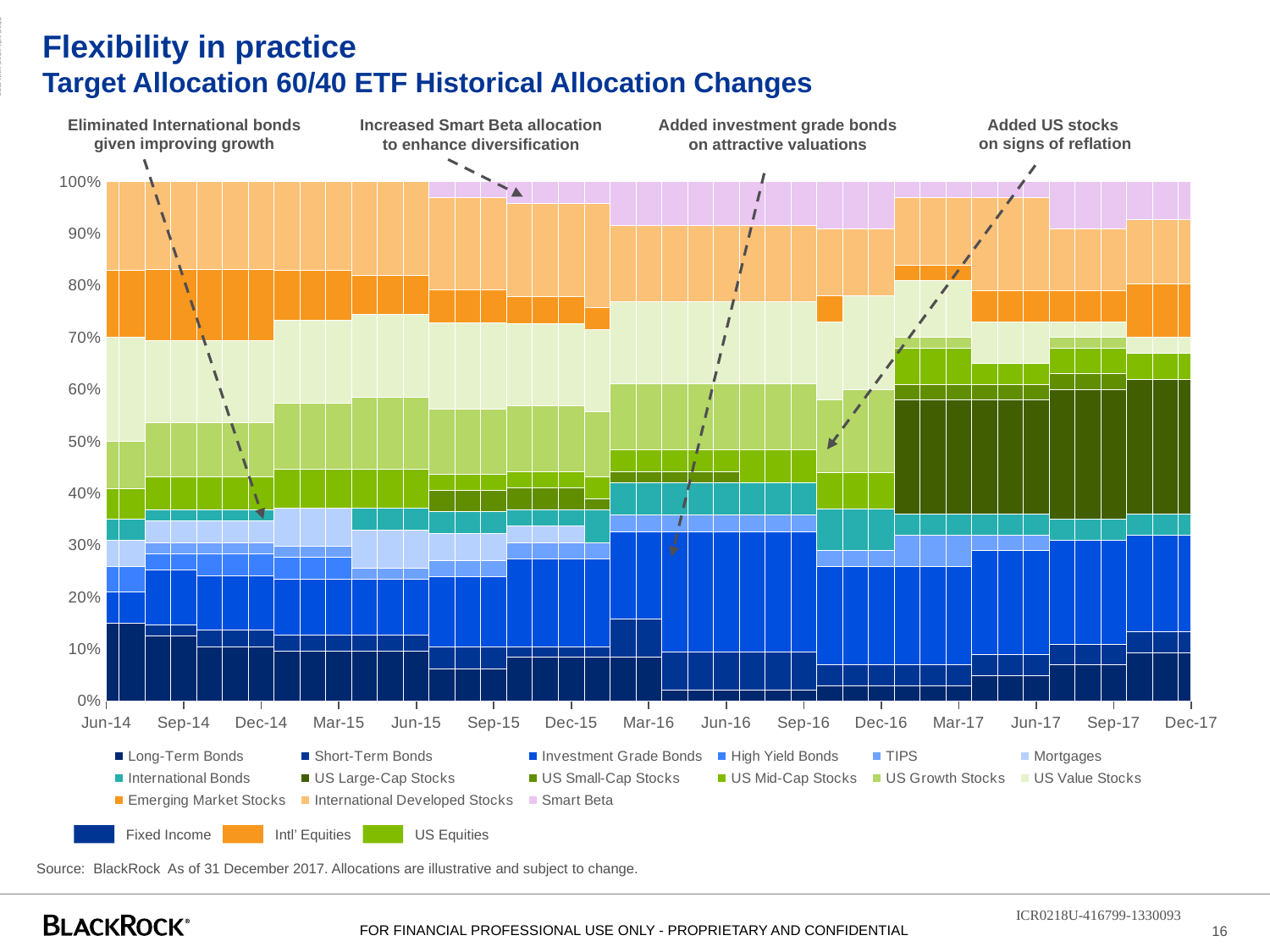
What kind of chart is shown on the slide? Stacked bar chart What is the title of the chart on the slide? Target Allocation 60/40 ETF Historical Allocation Changes Does the Smart Beta allocation rise or fall from Jun-14 to Dec-17? rise Is the Long-Term Bonds allocation for Dec-16 greater or less than 10%? less How many series does the chart legend list? 15 Is the Smart Beta allocation larger in Jun-14 or in Dec-17? Dec-17 According to the annotation, why were International bonds eliminated? Given improving growth Does the International Developed Stocks allocation rise or fall from Jun-14 to Dec-17? fall Is the Long-Term Bonds allocation larger in Jun-14 or in Dec-16? Jun-14 Is the Long-Term Bonds allocation for Jun-14 greater or less than 10%? greater